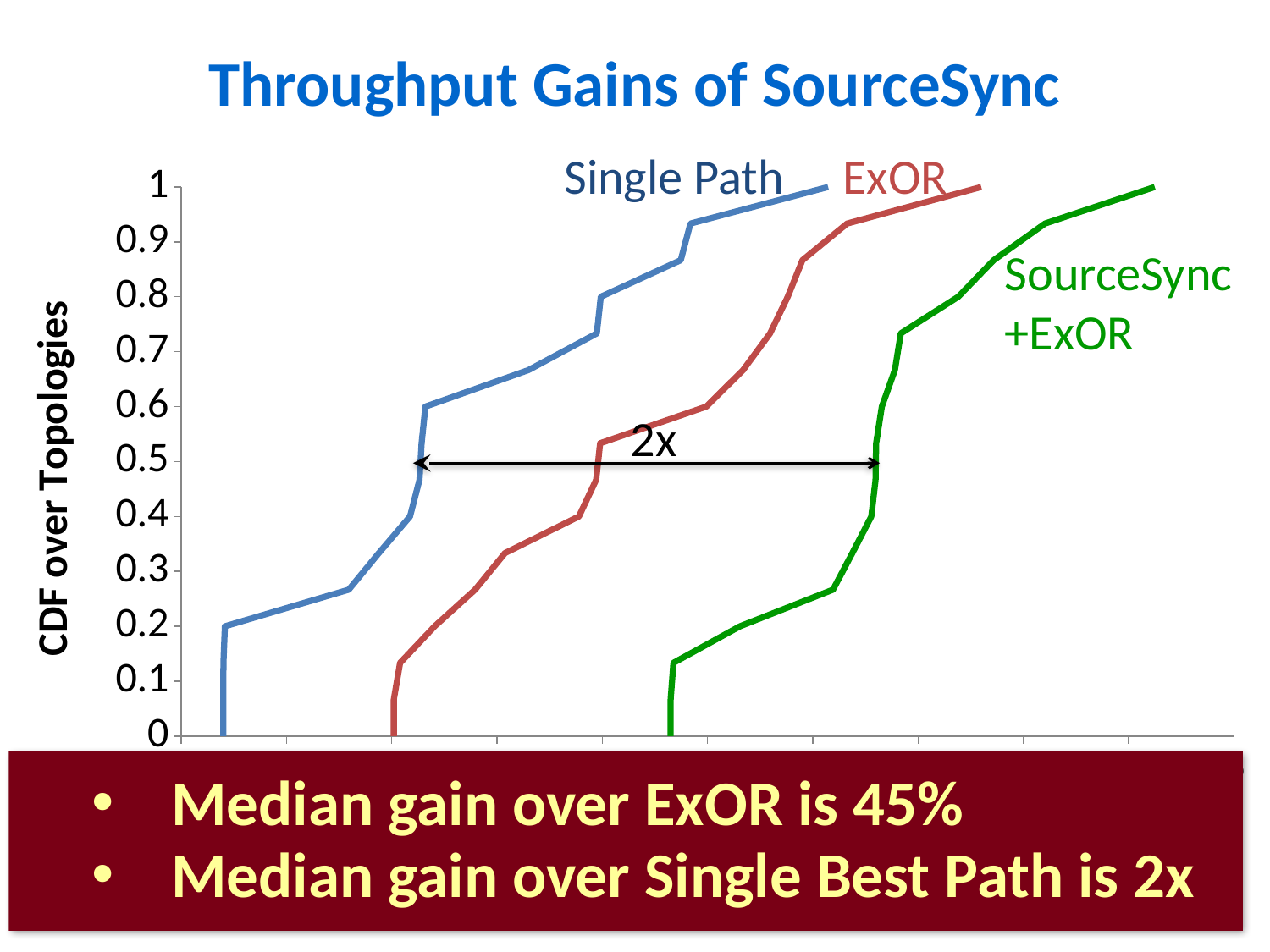
What is the title of the chart on the slide? Throughput Gains of SourceSync Do the CDF curves rise or fall as you move along the x axis? rise What kind of chart is shown on the slide? line chart What is the maximum value shown on the y axis? 1 How many series (curves) are plotted on the chart? 3 Which series' curve lies furthest to the left on the chart? Single Path According to the annotation, what is the median gain of SourceSync over Single Best Path? 2x Which series' curve lies furthest to the right on the chart? SourceSync+ExOR What is the label of the y axis? CDF over Topologies At which CDF value on the y axis is the '2x' arrow drawn? 0.5 According to the annotation, what is the median gain of SourceSync over ExOR? 45% Which series is drawn in green? SourceSync+ExOR